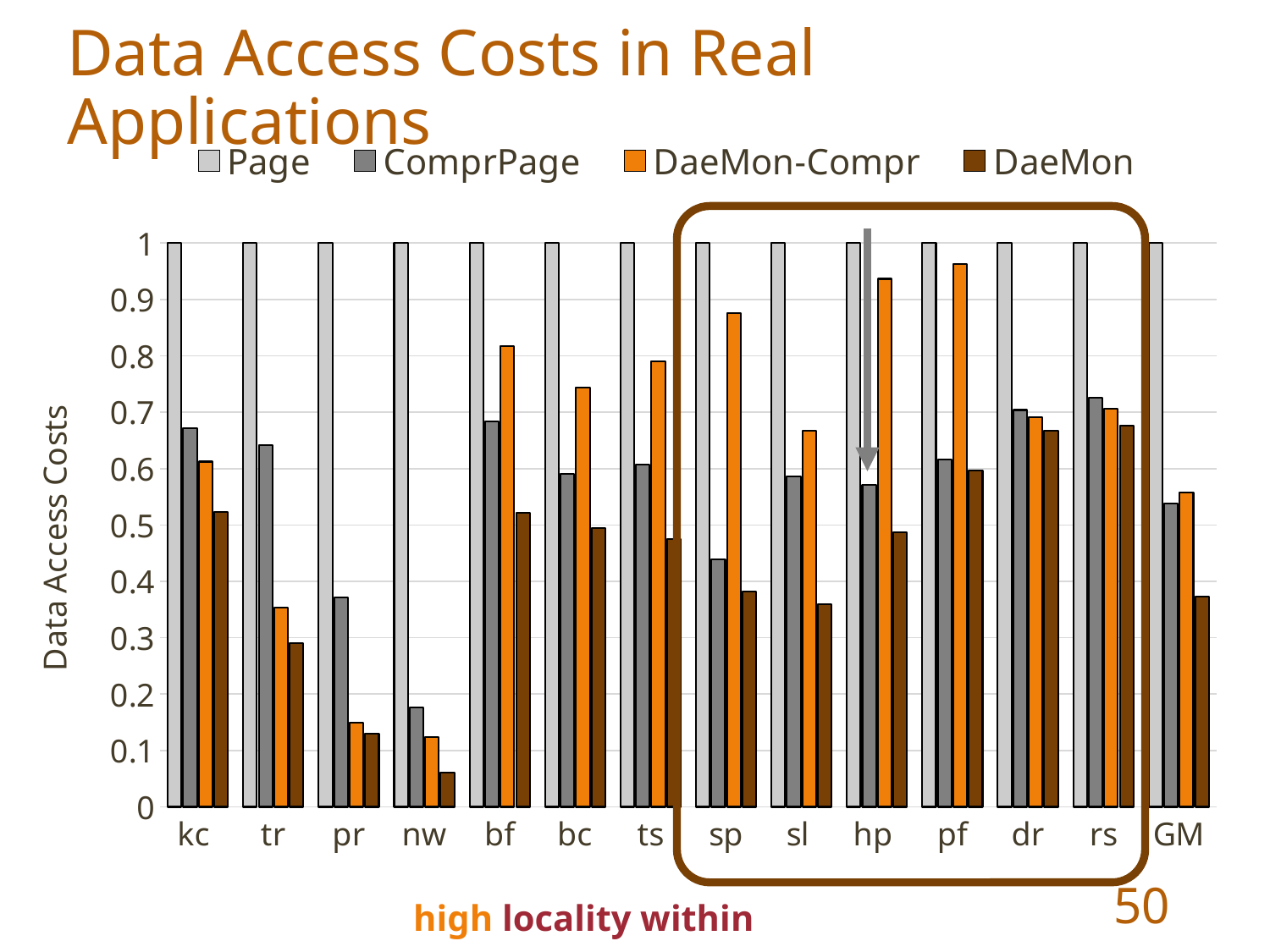
Is the DaeMon value for GM greater or less than 0.4? less What is the title of the y axis? Data Access Costs For bf, which is larger: the ComprPage value or the DaeMon-Compr value? DaeMon-Compr Is the DaeMon value for nw greater or less than 0.1? less How many categories are shown along the x axis? 14 Which category has the lowest ComprPage value? nw Is the DaeMon-Compr value for tr greater or less than 0.4? less What is the value of the Page series for kc? 1 How many series does the legend list? 4 What kind of chart is shown on the slide? bar chart Which category has the lowest DaeMon value? nw